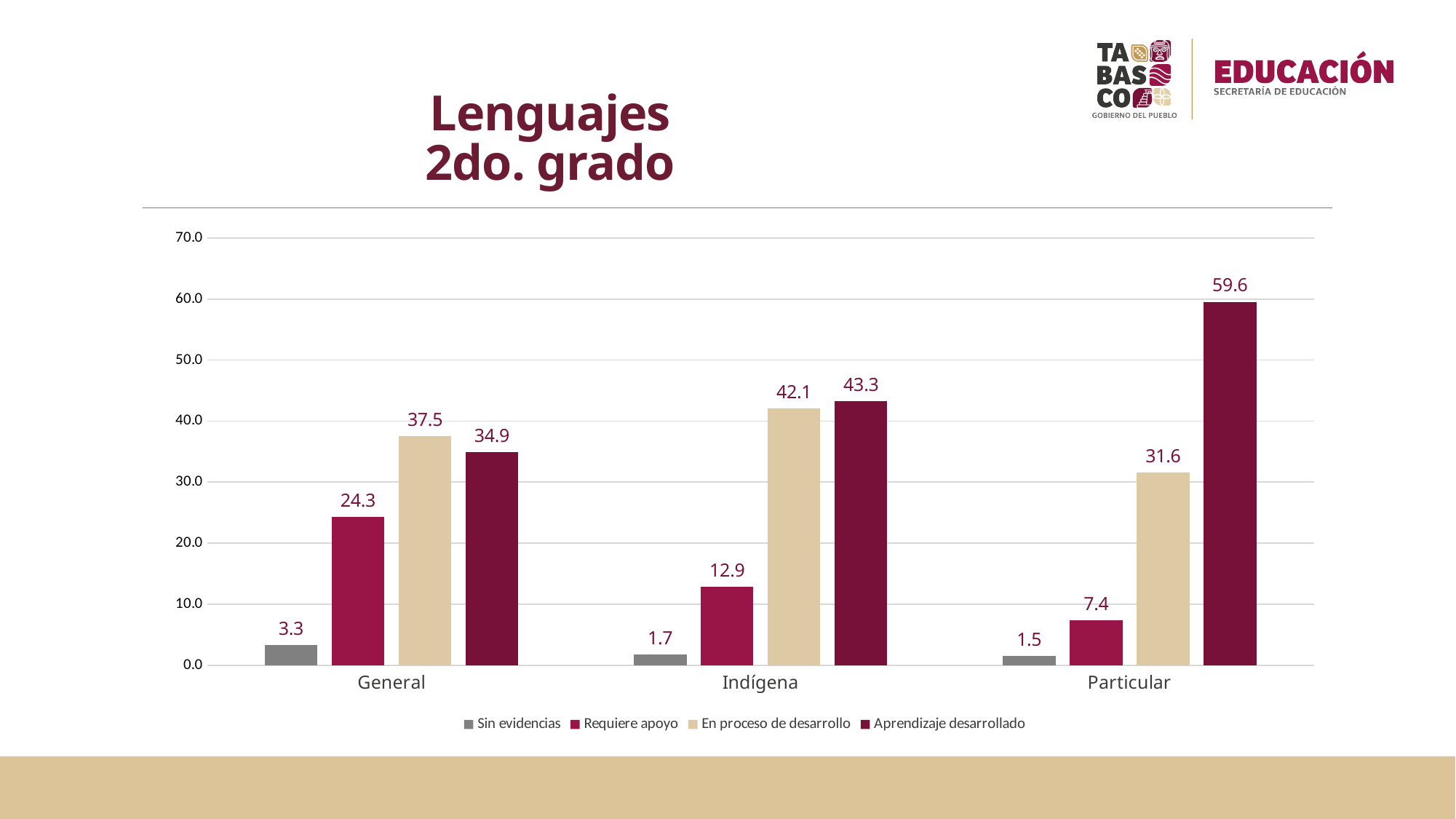
Which category has the lowest value for 'Sin evidencias'? Particular How many series does the legend list? 4 What is the value for 'Aprendizaje desarrollado' in the Particular category? 59.6 What is the value for 'En proceso de desarrollo' in the Indígena category? 42.1 What is the title of the slide? Lenguajes 2do. grado How many categories are shown on the x axis? 3 What is the value for 'Requiere apoyo' in the General category? 24.3 What kind of chart is shown on the slide? Bar chart Is the value for 'Requiere apoyo' in the Indígena category greater or less than 10.0? greater What is the difference between 'En proceso de desarrollo' and 'Aprendizaje desarrollado' in the General category? 2.6 Which is larger in the Indígena category: 'En proceso de desarrollo' or 'Aprendizaje desarrollado'? Aprendizaje desarrollado Which category has the highest value for 'Aprendizaje desarrollado'? Particular